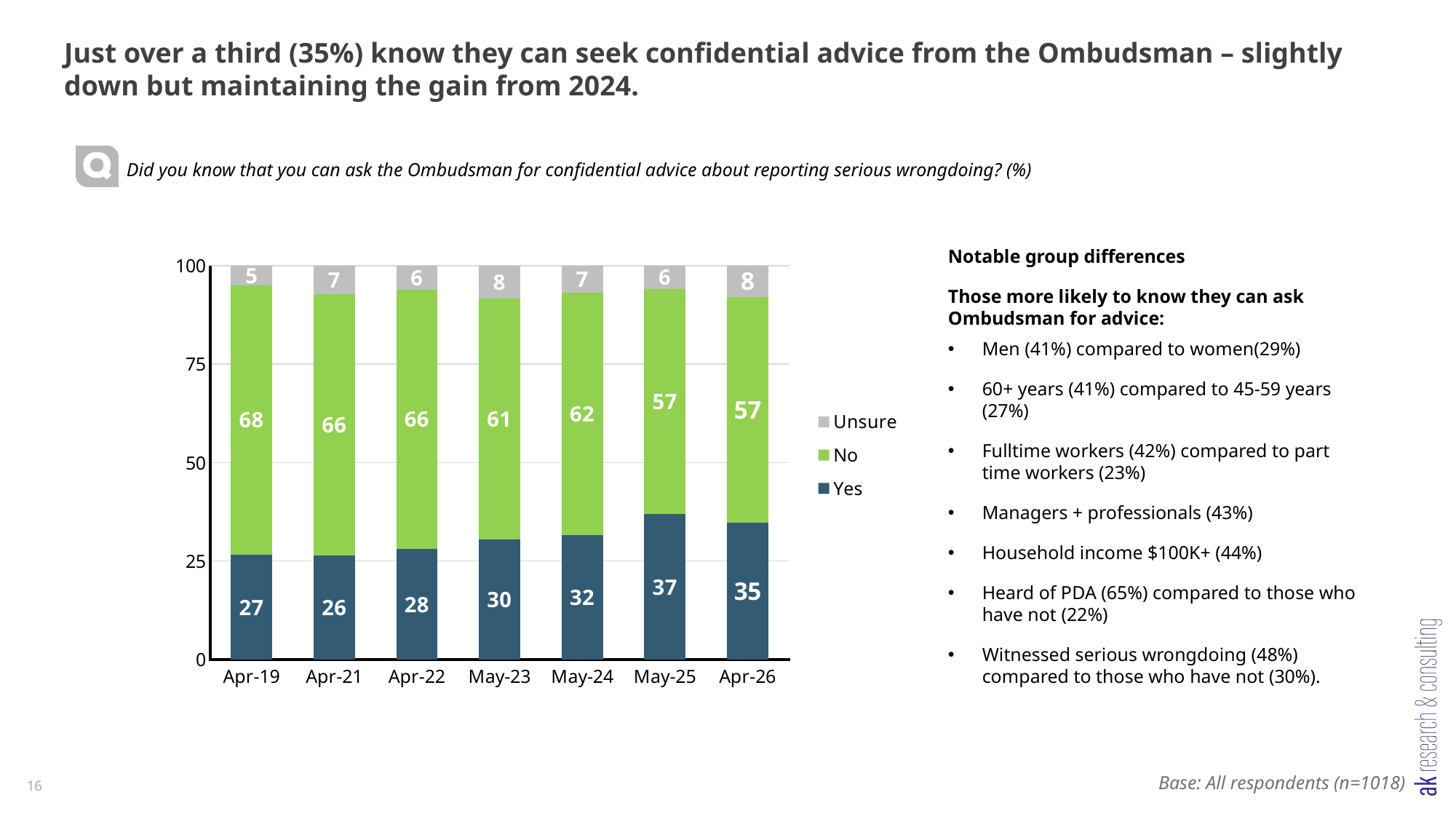
How many series does the legend list? 3 Which period has the lowest 'Yes' value? Apr-21 What is the 'Yes' value for Apr-26? 35 What kind of chart is shown? Stacked bar chart How many periods are shown on the x axis? 7 Which period has the highest 'Yes' value? May-25 What is the 'Unsure' value for May-23? 8 Which is larger, the 'No' value for Apr-22 or the 'No' value for May-24? Apr-22 Do the 'Yes' values generally rise or fall from Apr-21 to May-25? Rise What is the total of the stacked bar for May-25? 100 What is the difference between the 'Yes' values for May-25 and Apr-26? 2 What is the 'No' value for Apr-19? 68